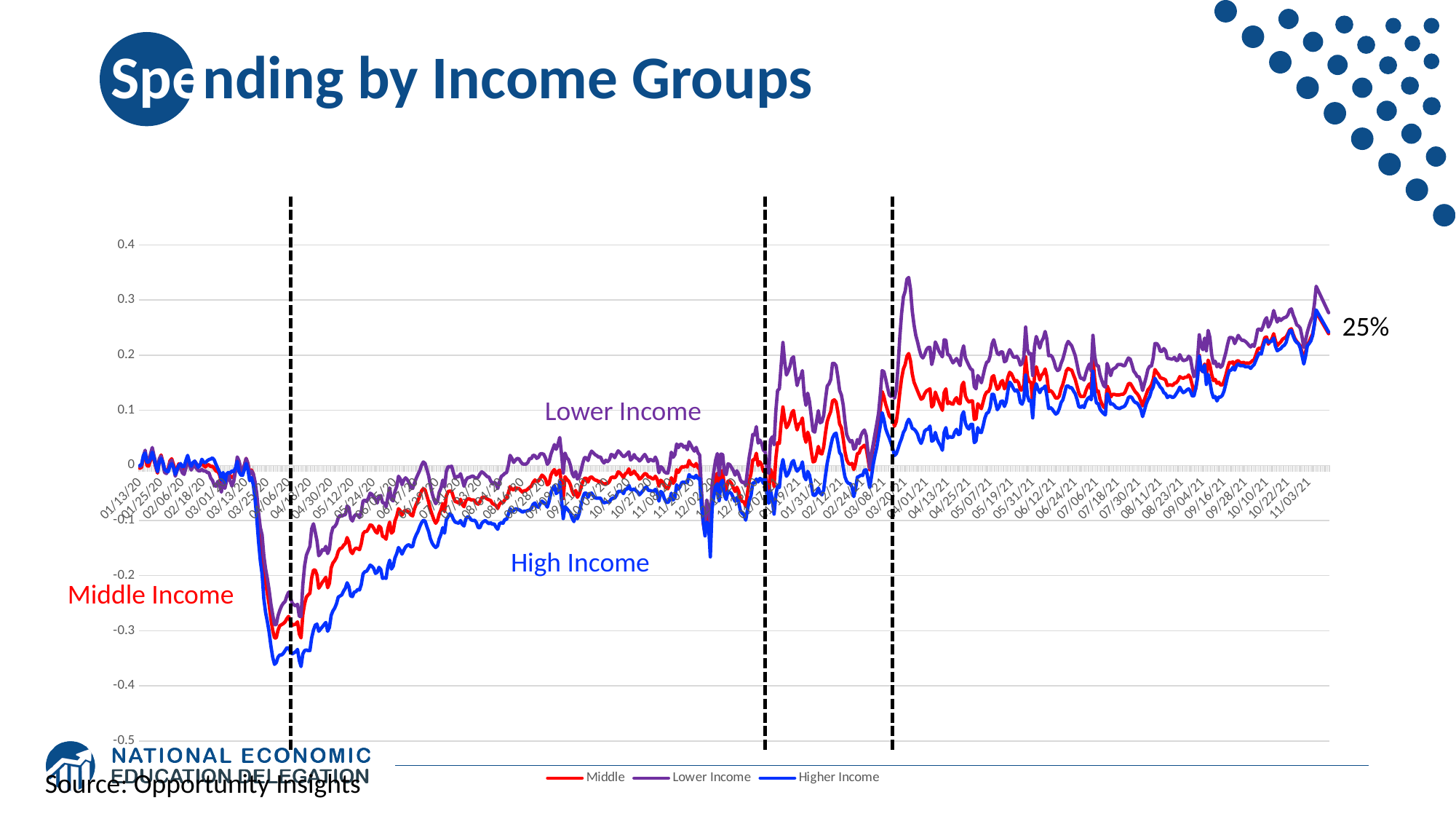
Do the values for all three income groups generally rise or fall from 04/06/20 to 11/03/21? rise Around 04/01/21, which is larger: the Lower Income value or the Higher Income value? Lower Income Is the Lower Income value at its peak around 04/01/21 greater or less than 0.3? greater What percentage is annotated at the right end of the lines? 25% Which income group's line reaches the highest value on the chart, at its peak around 04/01/21? Lower Income What kind of chart is shown on the slide? Line chart Is the Higher Income value at the start of the series (01/13/20) greater or less than 0.1? less Which income group's line falls to the lowest value on the chart, around 04/06/20? Higher Income Is the Middle income value at the end of the series (11/03/21) greater or less than 0.2? greater What are the three series listed in the legend? Middle, Lower Income, Higher Income How many series does the legend list? 3